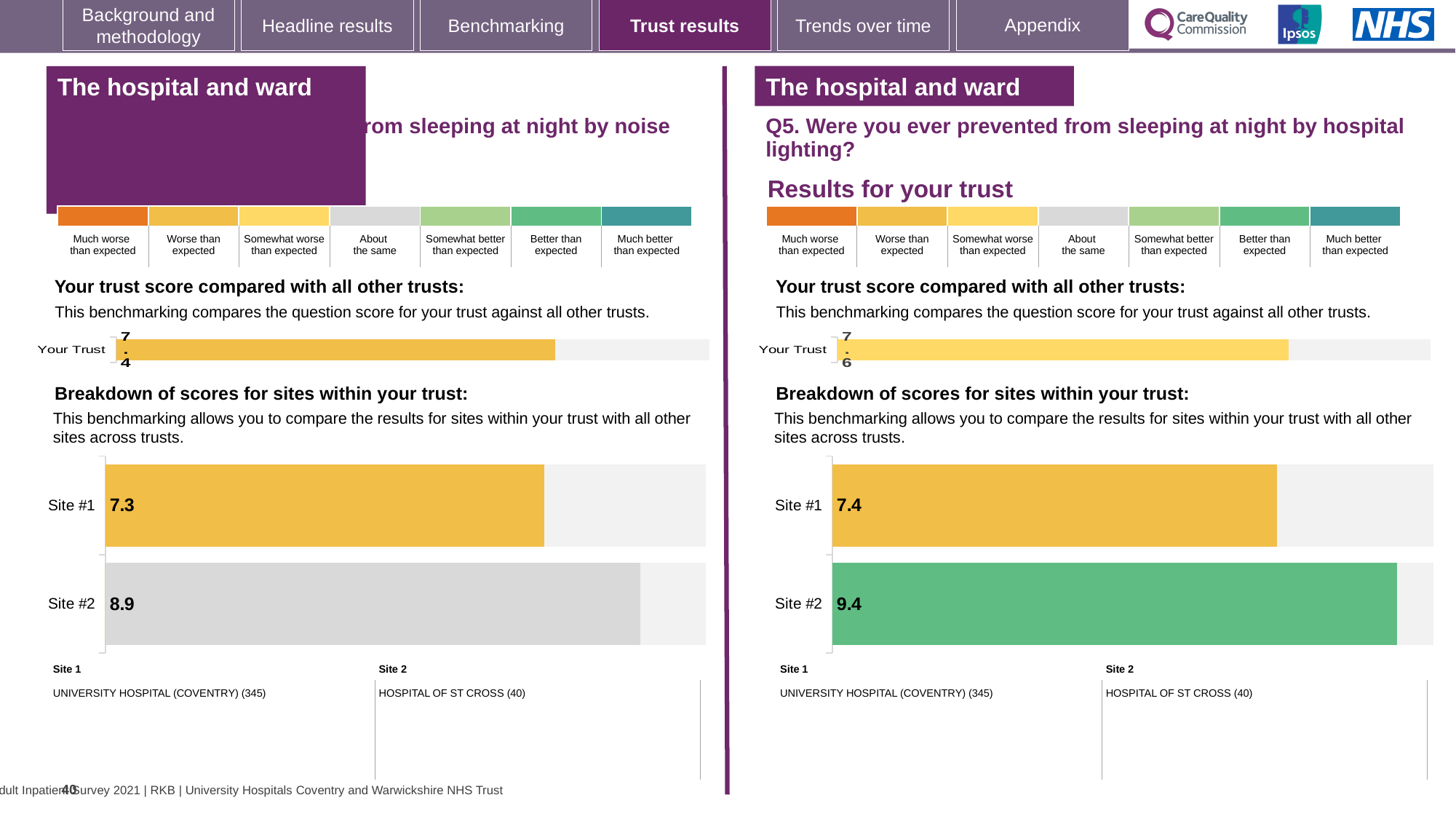
On the left-hand site breakdown chart (sleeping at night by noise), which site has the lower score? Site #1 On the right-hand site breakdown chart (Q5, hospital lighting), what is the score for Site #1? 7.4 On the right-hand site breakdown chart (Q5, hospital lighting), what is the score for Site #2? 9.4 On the right-hand site breakdown chart (Q5, hospital lighting), what is the difference between the Site #2 and Site #1 scores? 2.0 What type of chart is used for the site breakdown on the left-hand side of the slide? Bar chart On the right-hand 'Your trust score compared with all other trusts' chart (Q5), what is the score for Your Trust? 7.6 On the left-hand site breakdown chart (sleeping at night by noise), what is the score for Site #1? 7.3 On the right-hand site breakdown chart (Q5, hospital lighting), which site has the higher score? Site #2 How many sites are shown in the right-hand site breakdown chart (Q5, hospital lighting)? 2 On the left-hand site breakdown chart (sleeping at night by noise), what is the difference between the Site #2 and Site #1 scores? 1.6 On the left-hand 'Your trust score compared with all other trusts' chart, what is the score for Your Trust? 7.4 On the left-hand site breakdown chart (sleeping at night by noise), what is the score for Site #2? 8.9